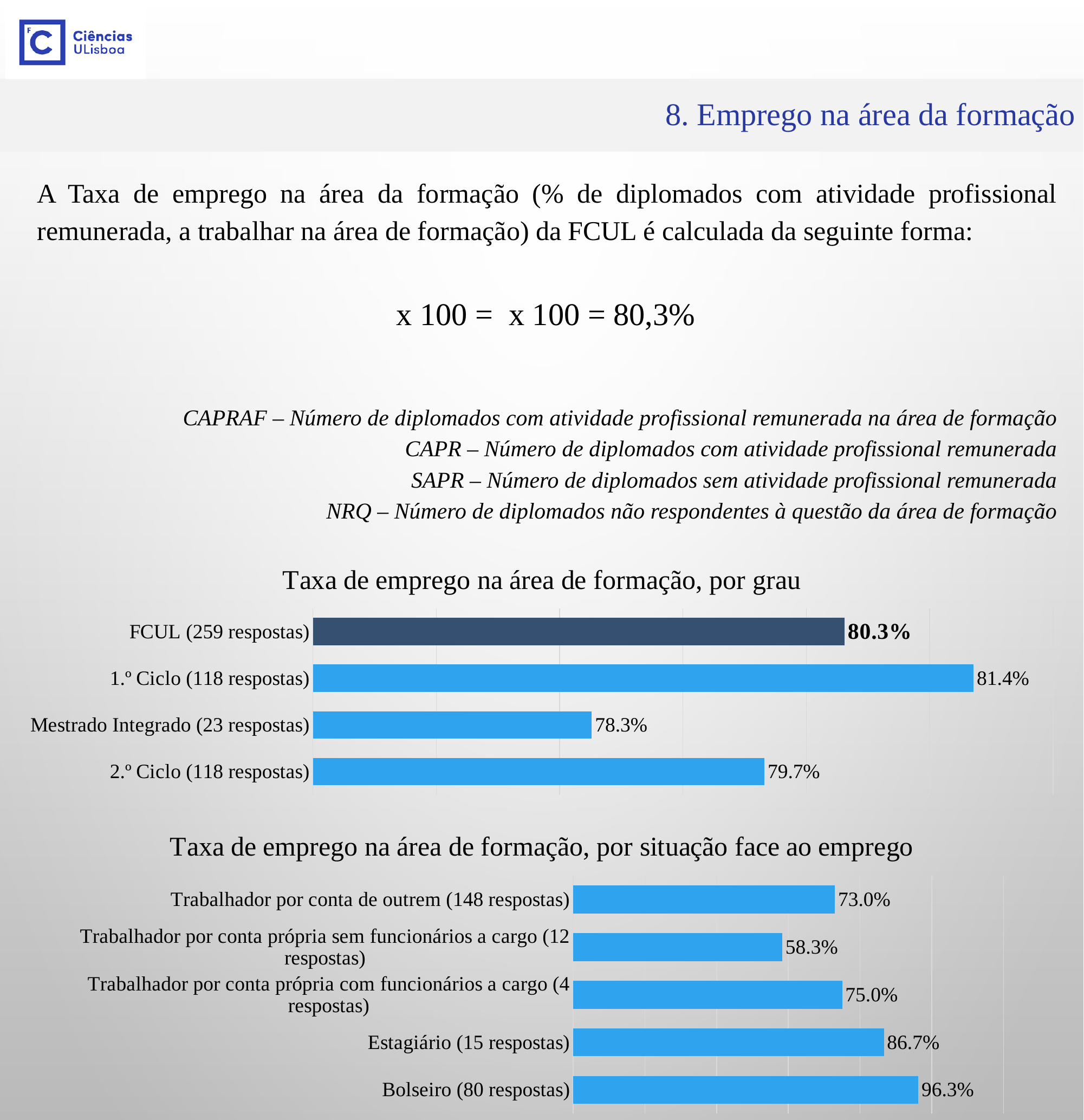
In the chart 'Taxa de emprego na área de formação, por situação face ao emprego', what is the value for Trabalhador por conta própria sem funcionários a cargo (12 respostas)? 58.3% In the chart 'Taxa de emprego na área de formação, por grau', which category has the highest value? 1.º Ciclo (118 respostas) In the chart 'Taxa de emprego na área de formação, por grau', what is the value for Mestrado Integrado (23 respostas)? 78.3% In the chart 'Taxa de emprego na área de formação, por situação face ao emprego', what is the value for Bolseiro (80 respostas)? 96.3% In the chart 'Taxa de emprego na área de formação, por grau', which category has the lowest value? Mestrado Integrado (23 respostas) In the chart 'Taxa de emprego na área de formação, por grau', what is the difference between the values for 1.º Ciclo and 2.º Ciclo? 1.7% In the chart 'Taxa de emprego na área de formação, por situação face ao emprego', which is larger: the value for Estagiário or the value for Trabalhador por conta de outrem? Estagiário In the chart 'Taxa de emprego na área de formação, por situação face ao emprego', which category has the highest value? Bolseiro (80 respostas) In the chart 'Taxa de emprego na área de formação, por situação face ao emprego', which category has the lowest value? Trabalhador por conta própria sem funcionários a cargo (12 respostas) In the chart 'Taxa de emprego na área de formação, por grau', how many categories are shown? 4 In the chart 'Taxa de emprego na área de formação, por grau', what is the value for FCUL (259 respostas)? 80.3% What kind of chart is 'Taxa de emprego na área de formação, por situação face ao emprego'? Bar chart